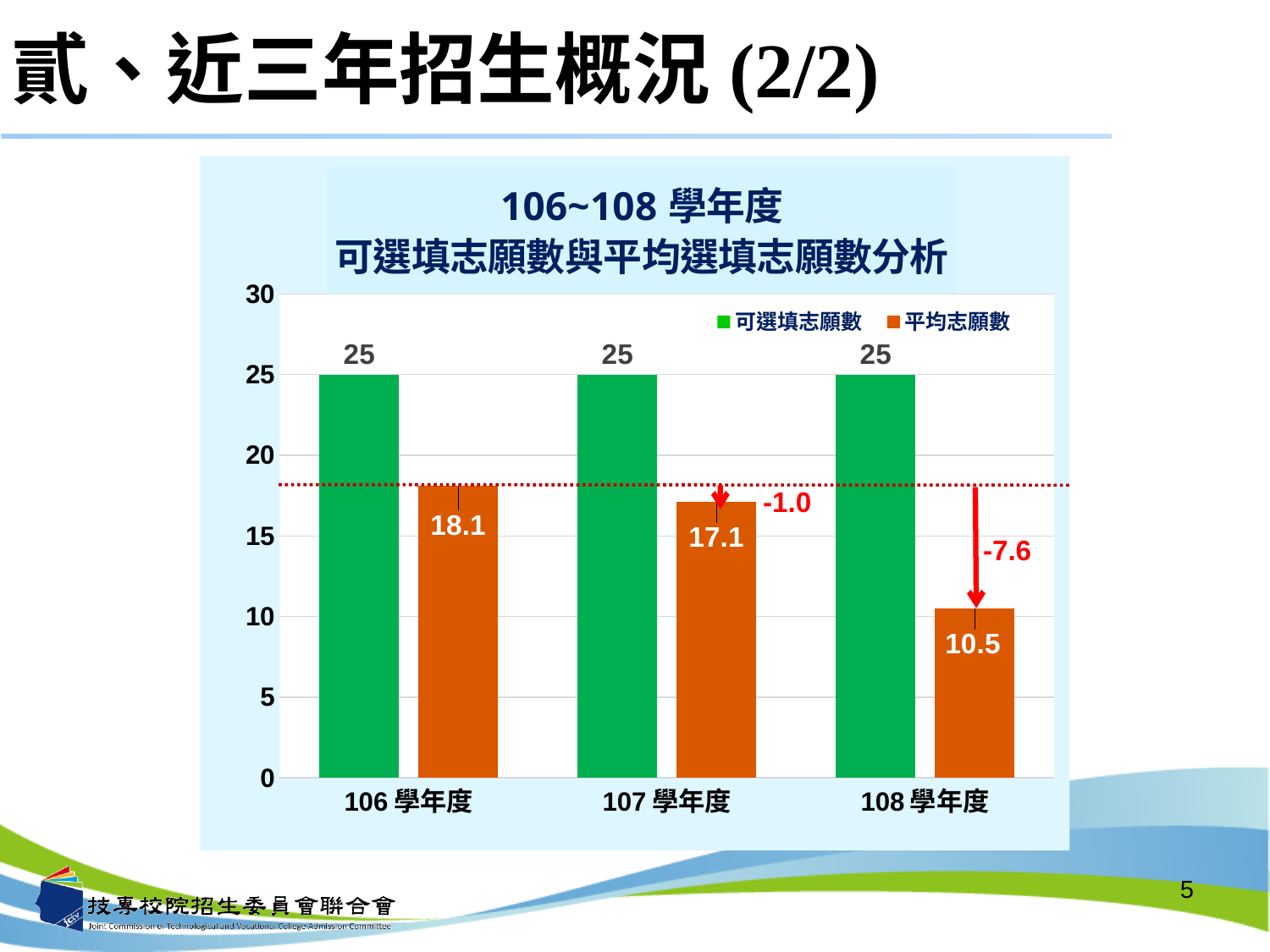
Which is larger, the 平均志願數 for 107 學年度 or for 108 學年度? 107 學年度 What is the difference between the 平均志願數 for 106 學年度 and 107 學年度? 1.0 Does the 平均志願數 rise or fall from 106 學年度 to 108 學年度? Fall How many 學年度 categories are shown on the x axis? 3 What is the 可選填志願數 value for 107 學年度? 25 What is the 平均志願數 value for 108 學年度? 10.5 How many series does the legend list? 2 Which 學年度 has the highest 平均志願數? 106 學年度 What is the difference between the 平均志願數 for 106 學年度 and 108 學年度? 7.6 What kind of chart is shown on the slide? Bar chart What is the 平均志願數 value for 106 學年度? 18.1 Which 學年度 has the lowest 平均志願數? 108 學年度